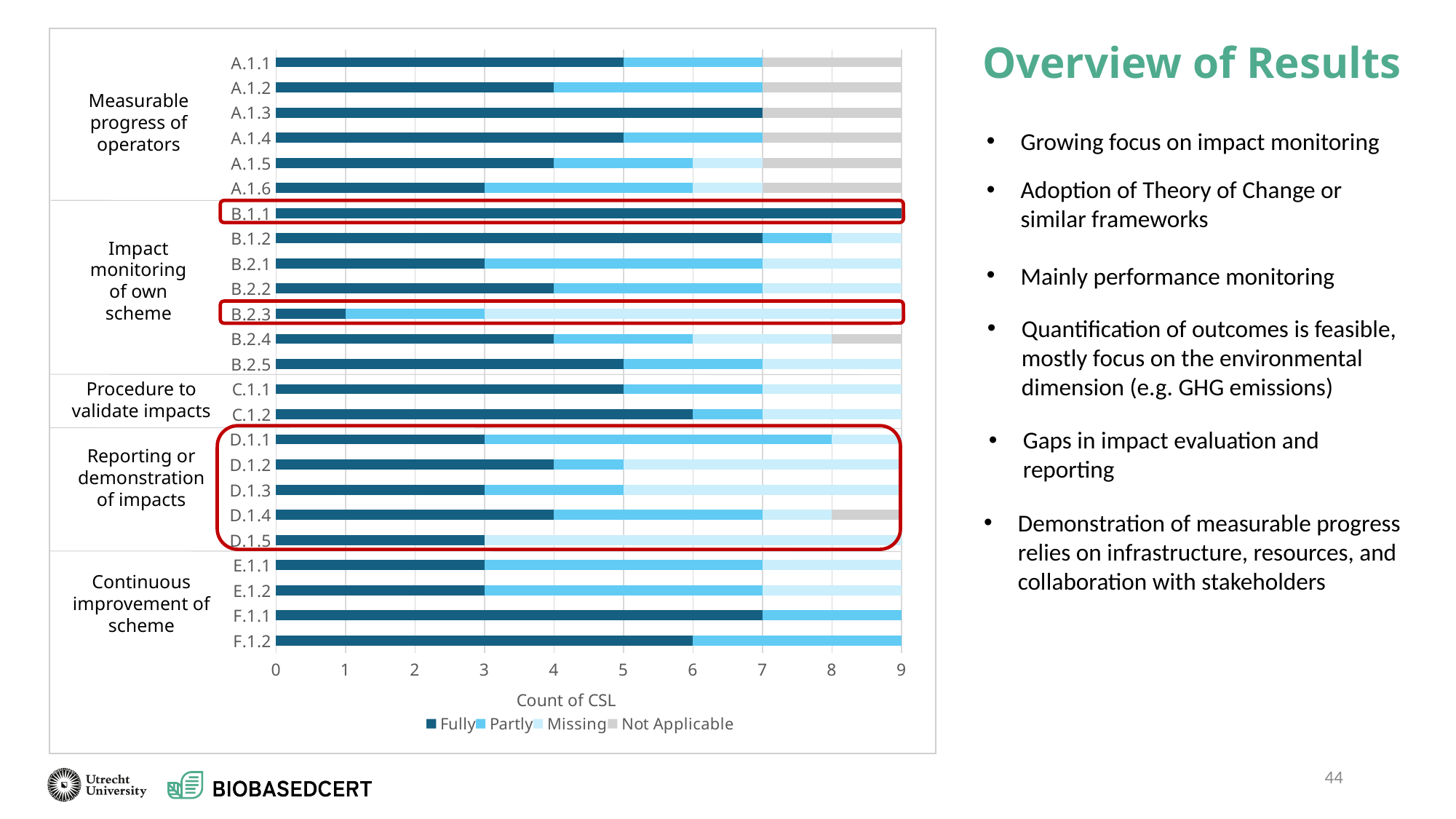
Which has a larger 'Fully' count, A.1.3 or A.1.6? A.1.3 What is the 'Fully' count for A.1.3? 7 Which indicator has the lowest 'Fully' count? B.2.3 Which indicator has the highest 'Fully' count? B.1.1 How many indicator categories (bars) are plotted in the chart? 24 What is the title of the x axis of the chart? Count of CSL What kind of chart is shown on the slide? Stacked bar chart How many series does the chart legend list? 4 Is the 'Fully' count for A.1.6 greater or less than 4? less What is the 'Fully' count for B.2.3? 1 What is the difference between the 'Fully' counts of B.1.1 and B.2.3? 8 What is the 'Fully' count for B.1.1? 9